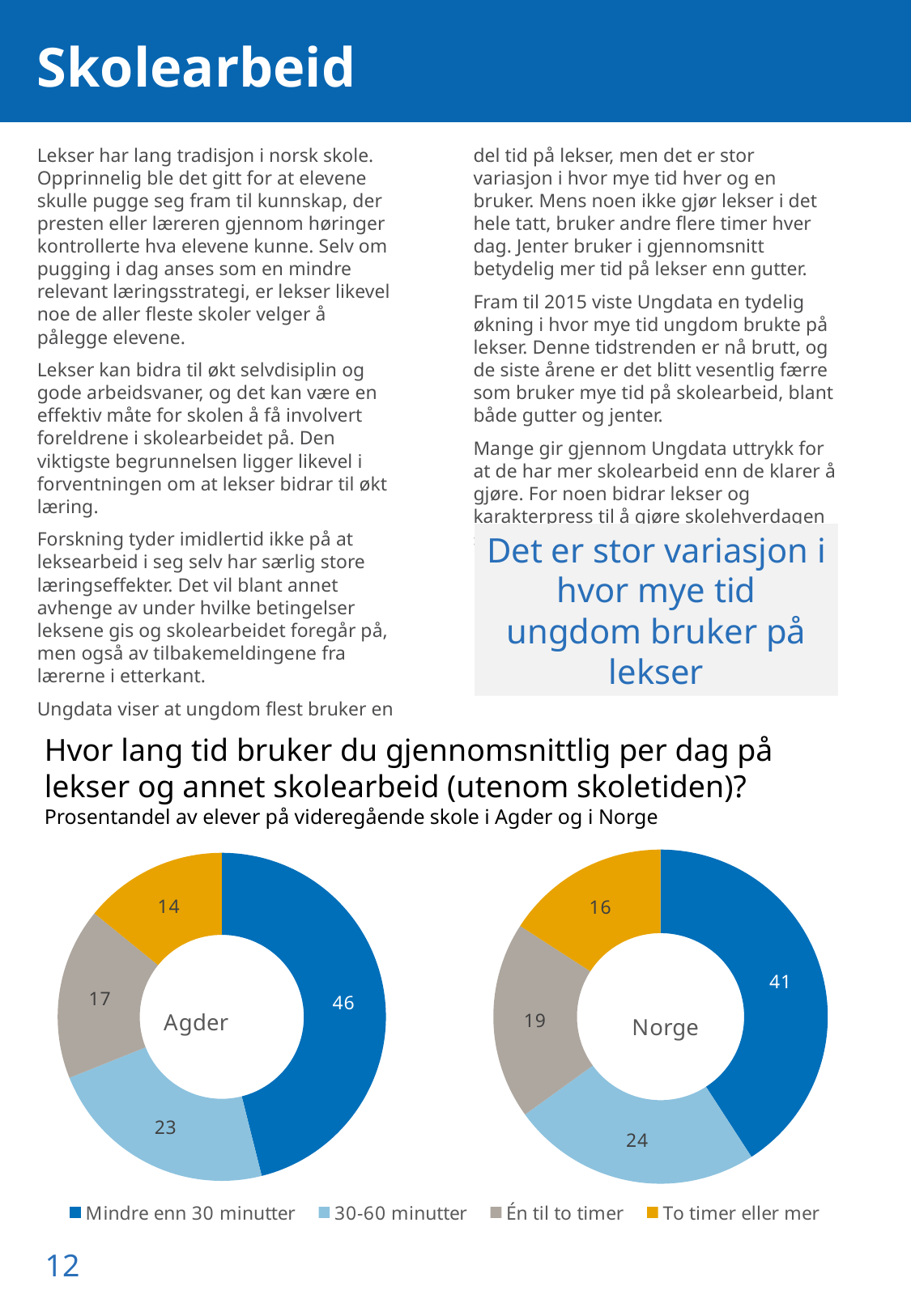
In the Norge donut chart, what is the value for To timer eller mer? 16 What is the difference between the Agder and Norge values for Mindre enn 30 minutter? 5 What type of chart is used to show the Agder and Norge data? Donut (pie) chart In the Agder donut chart, what is the value for Én til to timer? 17 In the Agder donut chart, what is the difference between the 30-60 minutter value and the To timer eller mer value? 9 In the Norge donut chart, what is the value for 30-60 minutter? 24 In the Norge donut chart, which category has the smallest share? To timer eller mer How many categories does each donut chart show? 4 Which colour represents the category 30-60 minutter in the legend? Light blue Which chart has the larger value for Én til to timer, Agder or Norge? Norge In the Agder donut chart, which category has the largest share? Mindre enn 30 minutter In the Agder donut chart, what percentage of pupils spend less than 30 minutes (Mindre enn 30 minutter) on homework per day? 46